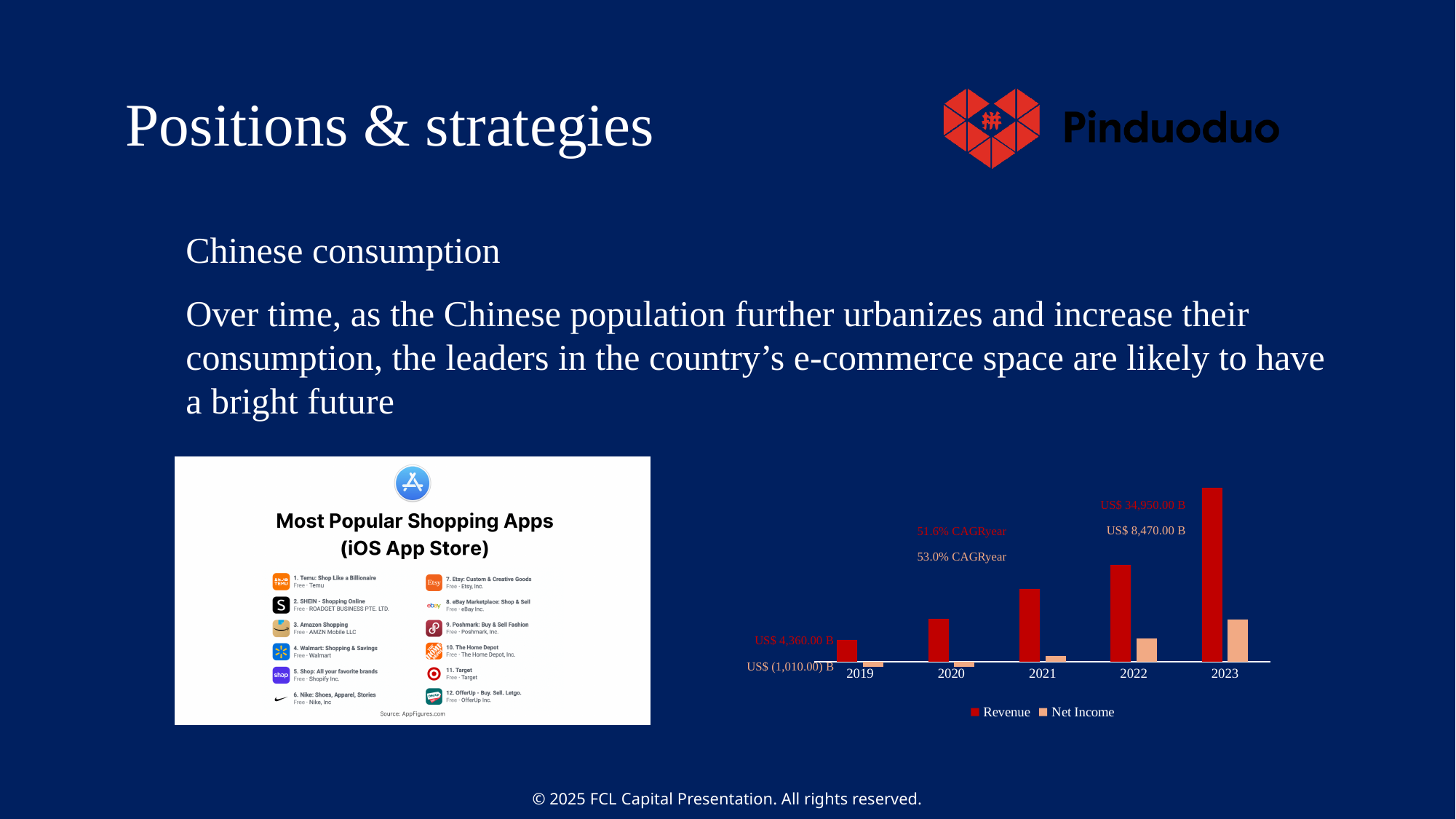
What is the Net Income value labelled for 2019 in the bar chart? US$ (1,010.00) B In 2023, which is larger in the bar chart: Revenue or Net Income? Revenue What is the difference between Revenue and Net Income in 2023 in the bar chart? US$ 26,480.00 B How many years are shown on the x axis of the bar chart? 5 What is the Net Income value labelled for 2023 in the bar chart? US$ 8,470.00 B Does Revenue rise or fall from 2019 to 2023 in the bar chart? rise What is the Revenue value labelled for 2023 in the bar chart? US$ 34,950.00 B What kind of chart is shown on the right side of the slide? bar chart Which year has the lowest Revenue in the bar chart? 2019 What is the Revenue value labelled for 2019 in the bar chart? US$ 4,360.00 B How many series does the legend of the bar chart list? 2 Which year has the highest Revenue in the bar chart? 2023